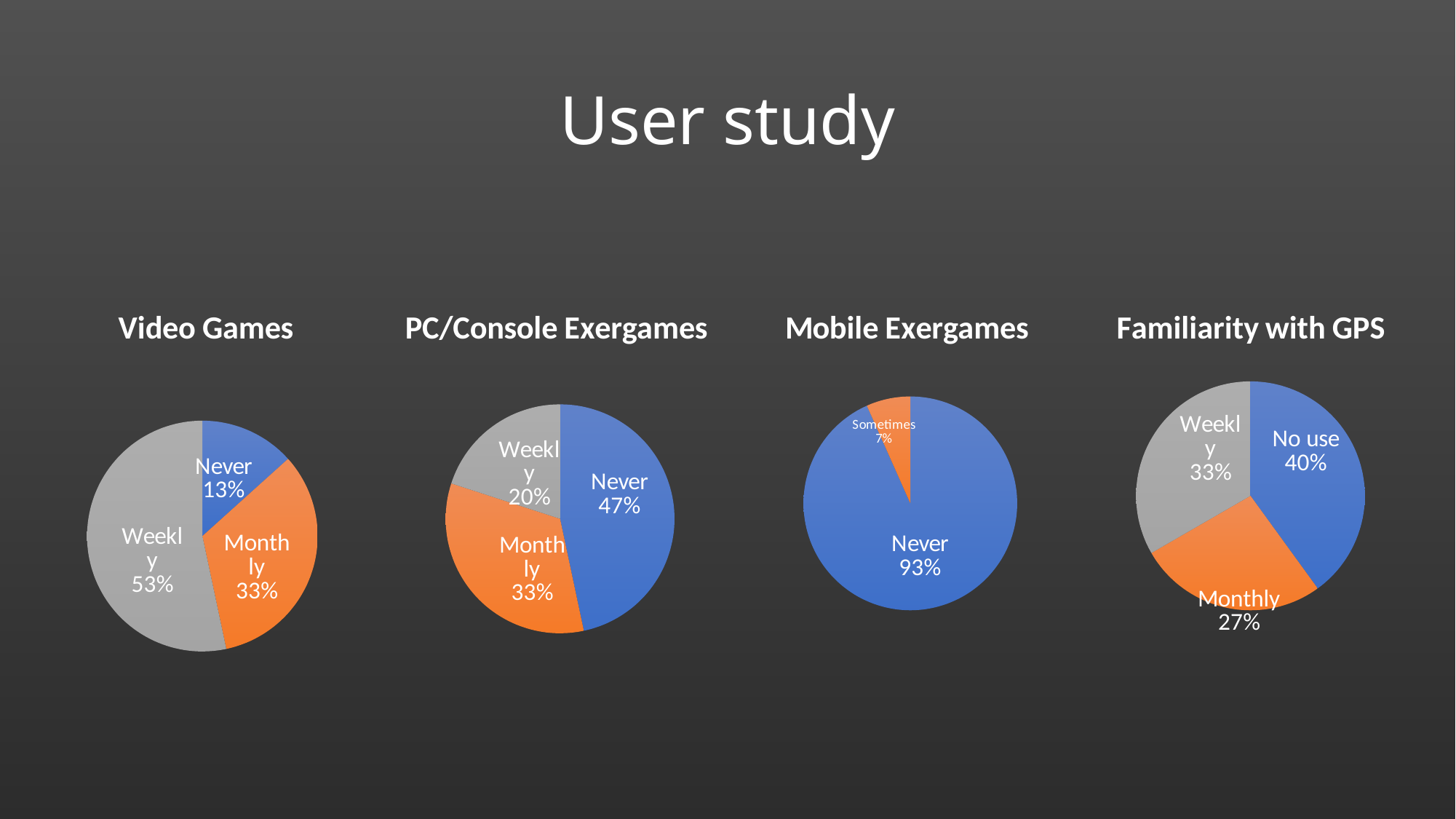
What kind of chart is used for Video Games? Pie chart In the Video Games chart, what share of respondents play weekly? 53% In the Mobile Exergames chart, how many slices does the pie have? 2 In the PC/Console Exergames chart, which category has the largest slice? Never In the Familiarity with GPS chart, what percentage is labelled No use? 40% In the PC/Console Exergames chart, what percentage is labelled Never? 47% In the Video Games chart, which category has the smallest slice? Never In the PC/Console Exergames chart, what is the difference between the Never and Weekly shares? 27% In the Familiarity with GPS chart, what is the difference between No use and Monthly? 13% In the Mobile Exergames chart, what share is labelled Sometimes? 7% In the Familiarity with GPS chart, which is larger, Weekly or Monthly? Weekly How many charts are shown on the slide? 4